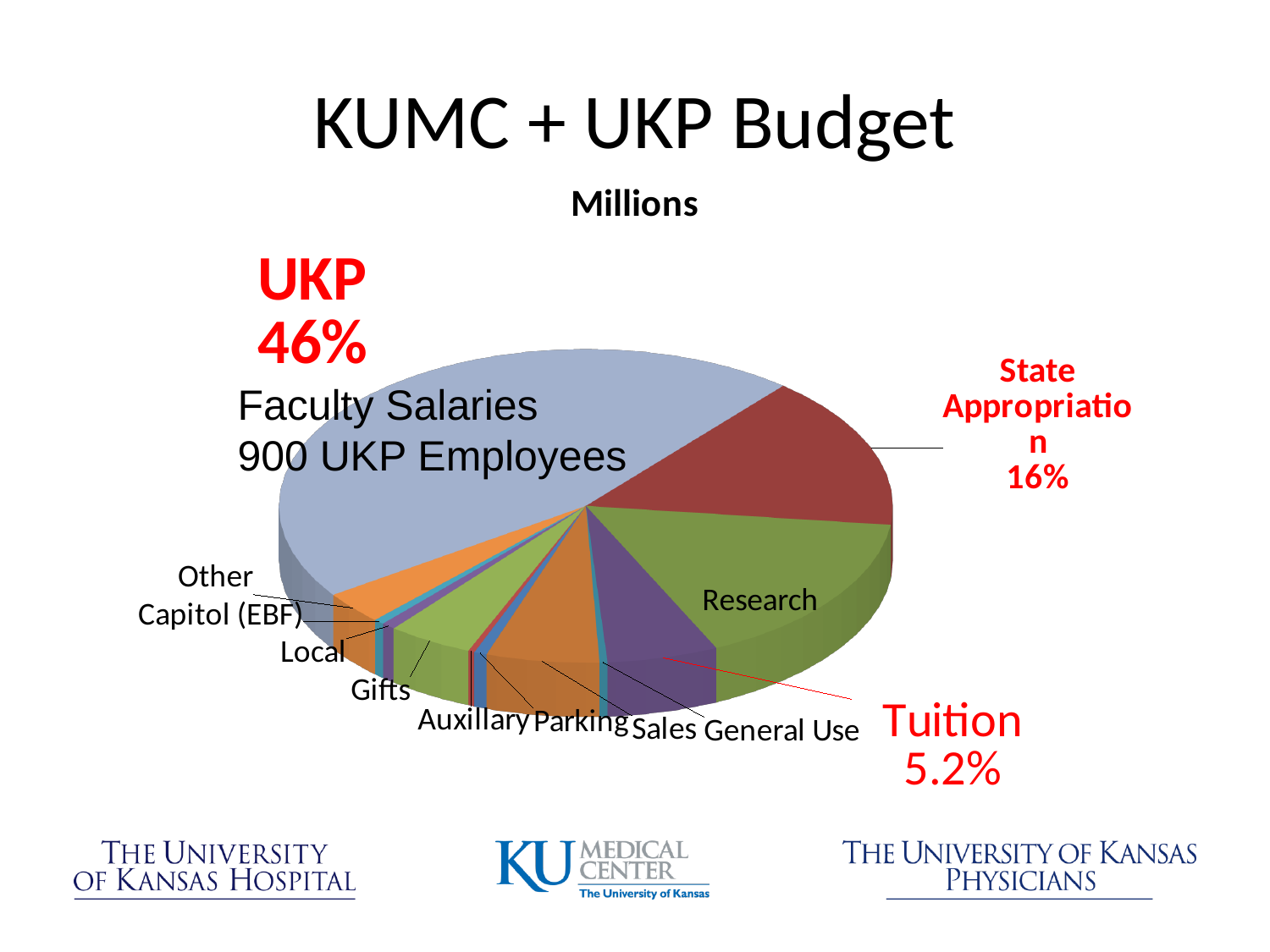
What kind of chart is shown on the slide? pie chart What share of the budget is Tuition? 5.2% Which is larger, the UKP slice or the State Appropriation slice? UKP By how many percentage points does State Appropriation's share exceed Tuition's share? 10.8 percentage points Which is larger, the State Appropriation slice or the Tuition slice? State Appropriation Which category has the largest slice of the pie? UKP What share of the budget is State Appropriation? 16% What is the title printed directly above the pie chart? Millions What share of the budget does UKP account for? 46% Which is larger, the Research slice or the Tuition slice? Research By how many percentage points does UKP's share exceed State Appropriation's share? 30 percentage points How many categories are shown in the pie chart? 12